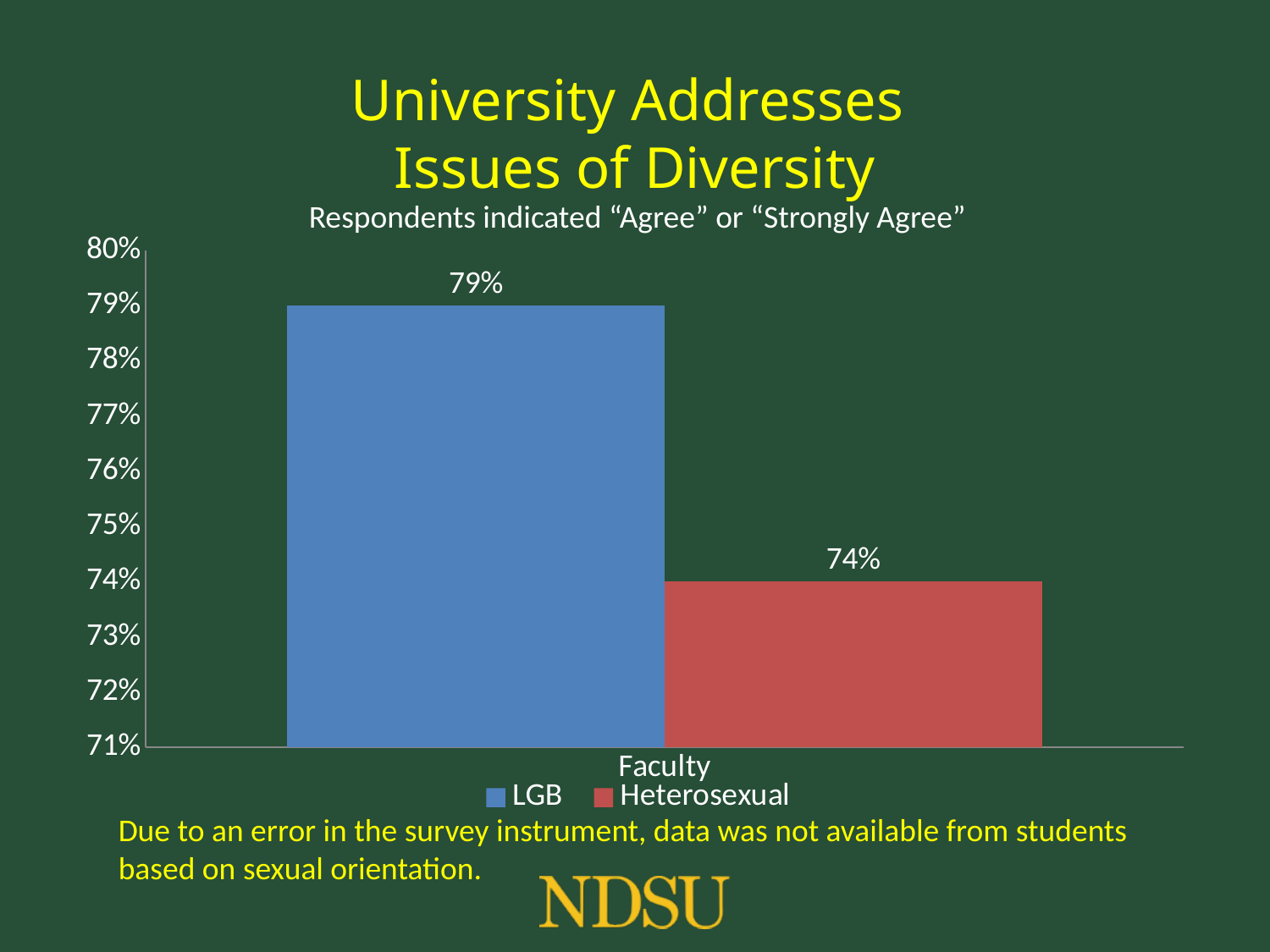
Which series has the lowest value on the chart? Heterosexual Which colour represents the Heterosexual series in the legend? Red Which series has the higher value for Faculty, LGB or Heterosexual? LGB How many categories are shown on the x axis? 1 What is the category label on the x axis? Faculty Is the value for Heterosexual faculty greater or less than 75%? less What is the difference in percentage points between the LGB and Heterosexual values for Faculty? 5 What percentage of Heterosexual faculty agreed that the university addresses issues of diversity? 74% What percentage of LGB faculty agreed that the university addresses issues of diversity? 79% What kind of chart is shown on the slide? Bar chart How many series does the legend list? 2 Is the value for LGB faculty greater or less than 78%? greater